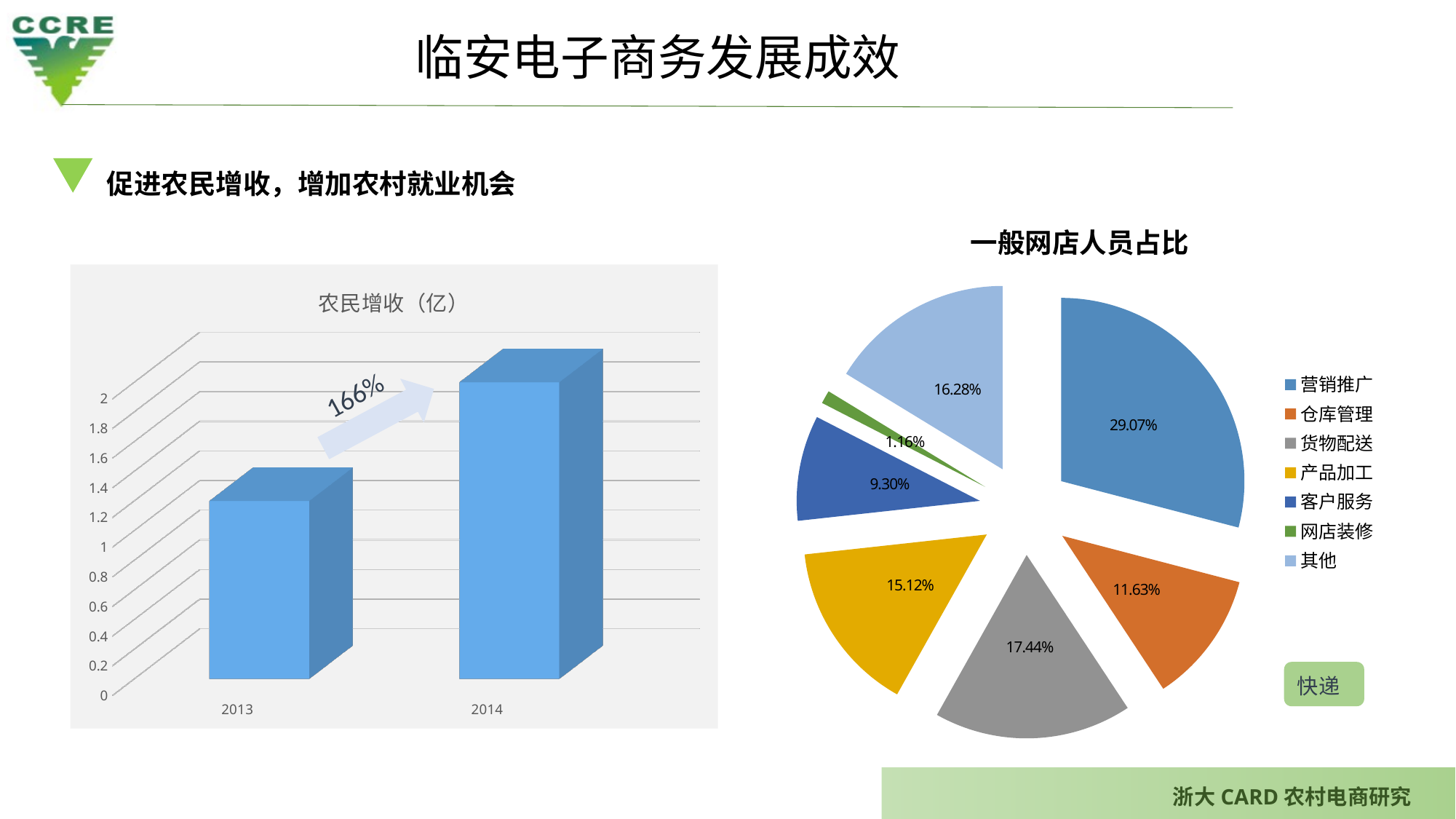
In the pie chart titled 一般网店人员占比, which category has the smallest share? 网店装修 In the bar chart titled 农民增收（亿）, what percentage is written on the arrow between the 2013 and 2014 bars? 166% In the pie chart titled 一般网店人员占比, which has a larger share, 产品加工 or 其他? 其他 What kind of chart is the chart titled 农民增收（亿）on the left of the slide? bar chart In the pie chart titled 一般网店人员占比, what is the share for 客户服务? 9.30% In the pie chart titled 一般网店人员占比, what is the share for 营销推广? 29.07% In the pie chart titled 一般网店人员占比, what is the difference between the shares of 营销推广 and 仓库管理? 17.44% In the bar chart titled 农民增收（亿）, is the value for 2014 greater or less than 1.6? greater In the pie chart titled 一般网店人员占比, which category has the largest share? 营销推广 In the bar chart titled 农民增收（亿）, which year has the larger value, 2013 or 2014? 2014 How many entries does the legend of the pie chart titled 一般网店人员占比 list? 7 In the pie chart titled 一般网店人员占比, what is the share for 货物配送? 17.44%